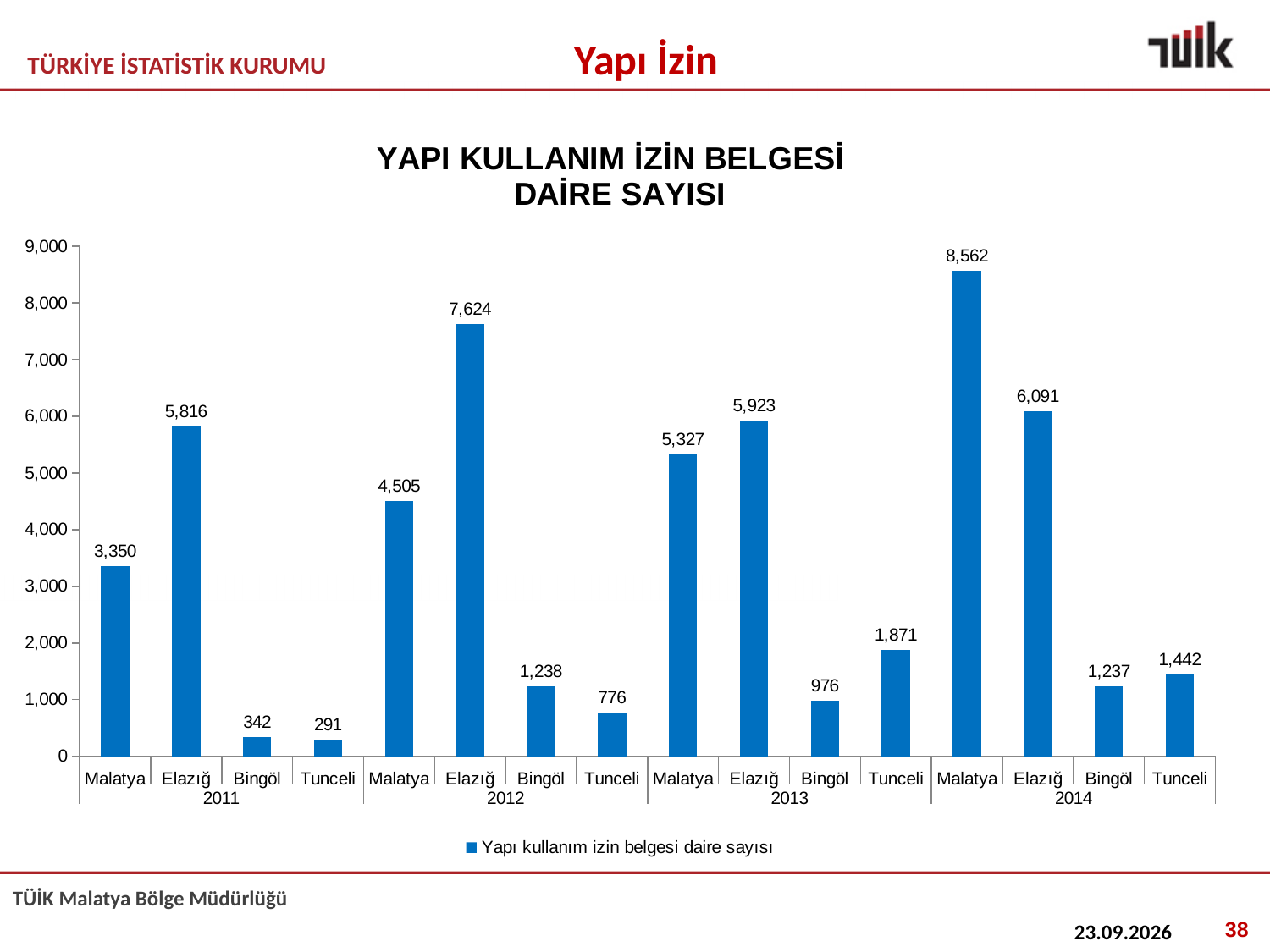
What kind of chart is shown on the slide? Bar chart What is the value for Bingöl in 2013? 976 Which bar has the lowest value in the chart? Tunceli 2011 Do the values for Malatya rise or fall from 2011 to 2014? Rise Which bar has the highest value in the chart? Malatya 2014 What is the value for Tunceli in 2011? 291 What is the value for Elazığ in 2012? 7,624 What is the value for Malatya in 2014? 8,562 Which is larger: Malatya in 2013 or Elazığ in 2013? Elazığ in 2013 What is the difference between Malatya in 2014 and Elazığ in 2014? 2,471 How many bars are plotted in the chart? 16 How many series does the legend list? 1